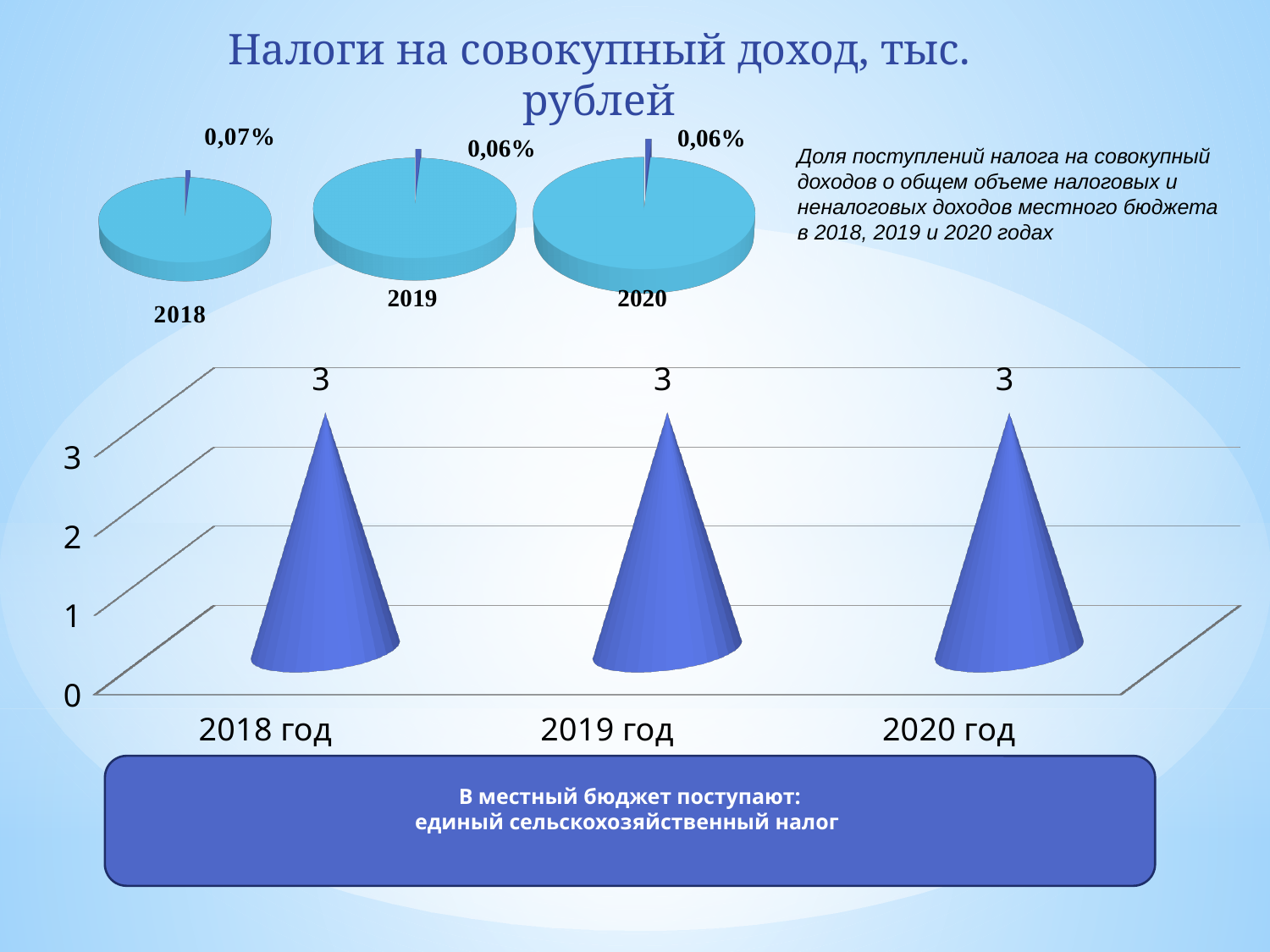
In the pie chart for 2018 at the top of the slide, what share is labelled on the small slice? 0,07% In the bottom chart, what is the difference between the values for 2018 год and 2020 год? 0 In the bottom chart, what is the value for 2019 год? 3 In the bottom chart, what is the value for 2018 год? 3 In the pie chart for 2020 at the top of the slide, what share is labelled on the small slice? 0,06% How many categories does the bottom chart show? 3 In the bottom chart, what is the value for 2020 год? 3 In the bottom chart, do the values rise, fall or stay the same from 2018 год to 2020 год? stay the same In the bottom chart, is the value for 2019 год greater or less than 2? greater What kind of chart is the bottom chart on the slide? bar chart What is the title of the slide's charts? Налоги на совокупный доход, тыс. рублей In the pie chart for 2019 at the top of the slide, what share is labelled on the small slice? 0,06%